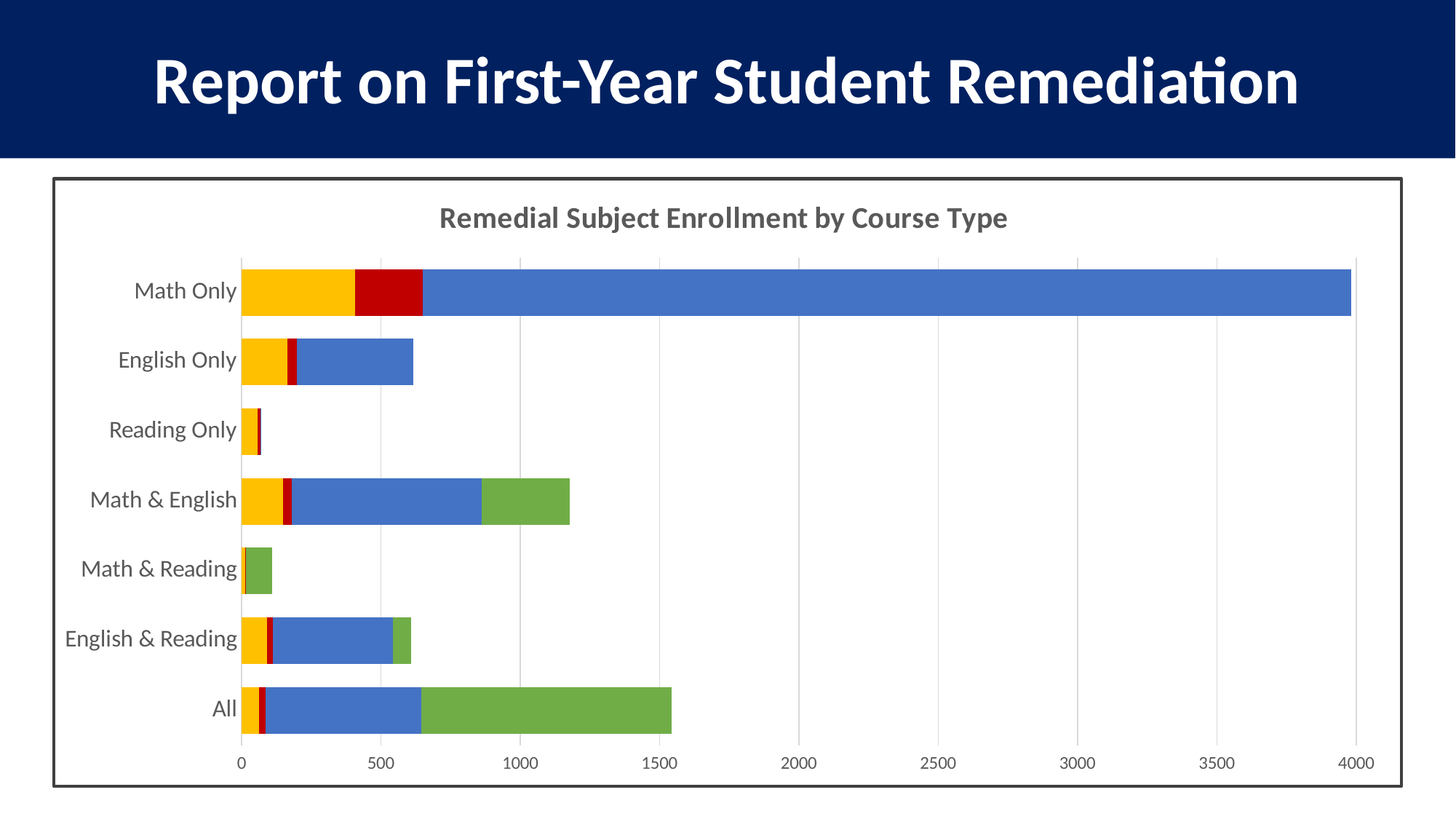
Is the total bar length for Math Only greater or less than 3500? greater Which has the longer total bar, Math & English or All? All Is the total bar length for All greater or less than 1000? greater What is the title of the chart? Remedial Subject Enrollment by Course Type Which course type has the longest total bar? Math Only What is the highest value shown on the horizontal axis? 4000 What kind of chart is shown on the slide? Stacked bar chart Is the total bar length for Math & Reading greater or less than 500? less Which course type has the shortest total bar? Reading Only How many course type categories are shown on the chart? 7